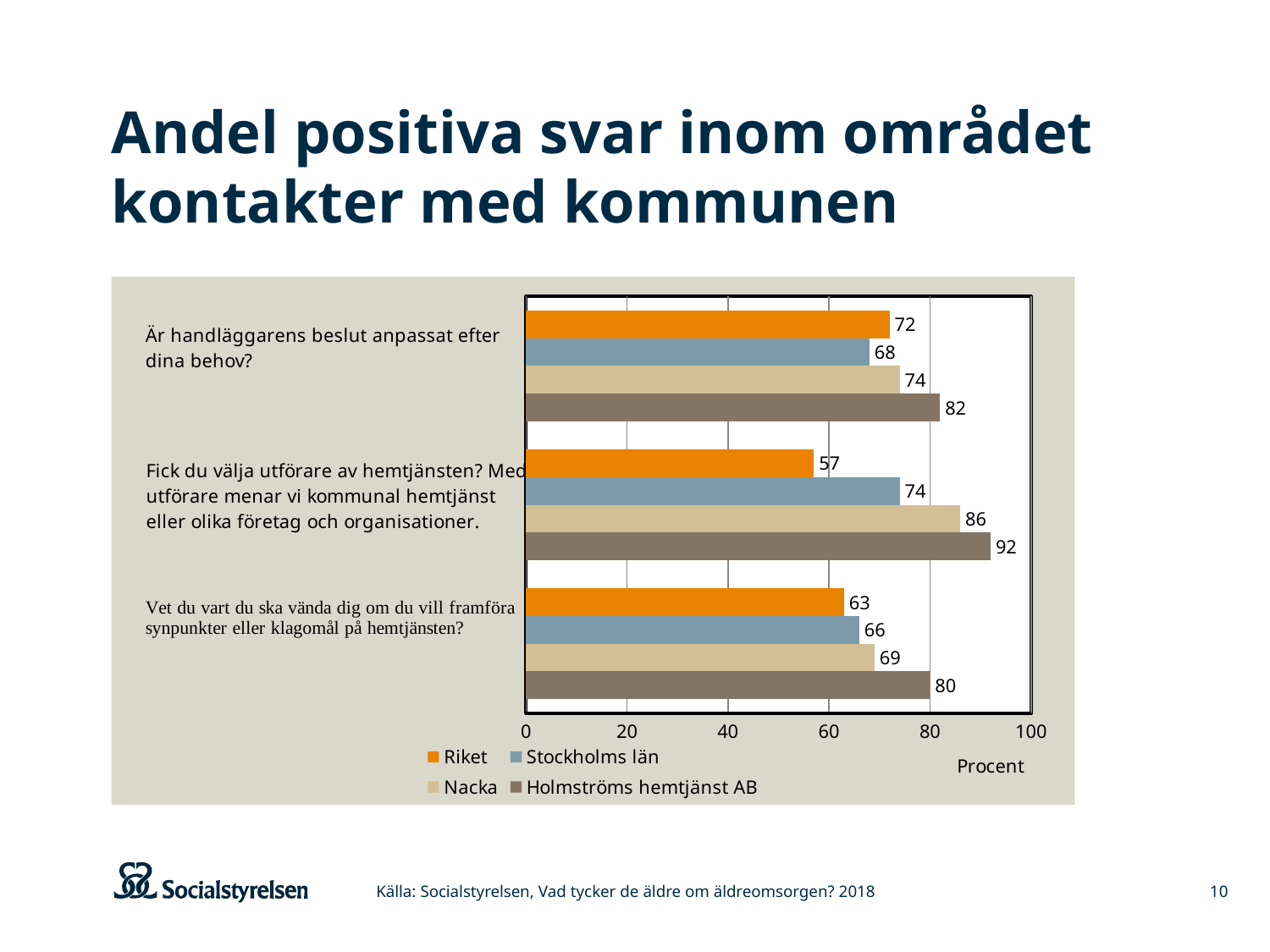
How many series does the legend list? 4 Which is larger on the question "Vet du vart du ska vända dig om du vill framföra synpunkter eller klagomål på hemtjänsten?": Riket or Nacka? Nacka Which series has the lowest value on the question "Fick du välja utförare av hemtjänsten?"? Riket What is the value for Holmströms hemtjänst AB on the question "Fick du välja utförare av hemtjänsten?"? 92 What is the value for Nacka on the question "Fick du välja utförare av hemtjänsten?"? 86 What kind of chart is shown on the slide? Bar chart What is the value for Riket on the question "Är handläggarens beslut anpassat efter dina behov?"? 72 What is the difference between Nacka and Stockholms län on the question "Är handläggarens beslut anpassat efter dina behov?"? 6 What is the label on the horizontal axis of the chart? Procent What is the difference between Holmströms hemtjänst AB and Riket on the question "Fick du välja utförare av hemtjänsten?"? 35 What is the value for Stockholms län on the question "Vet du vart du ska vända dig om du vill framföra synpunkter eller klagomål på hemtjänsten?"? 66 Which series has the highest value on the question "Vet du vart du ska vända dig om du vill framföra synpunkter eller klagomål på hemtjänsten?"? Holmströms hemtjänst AB